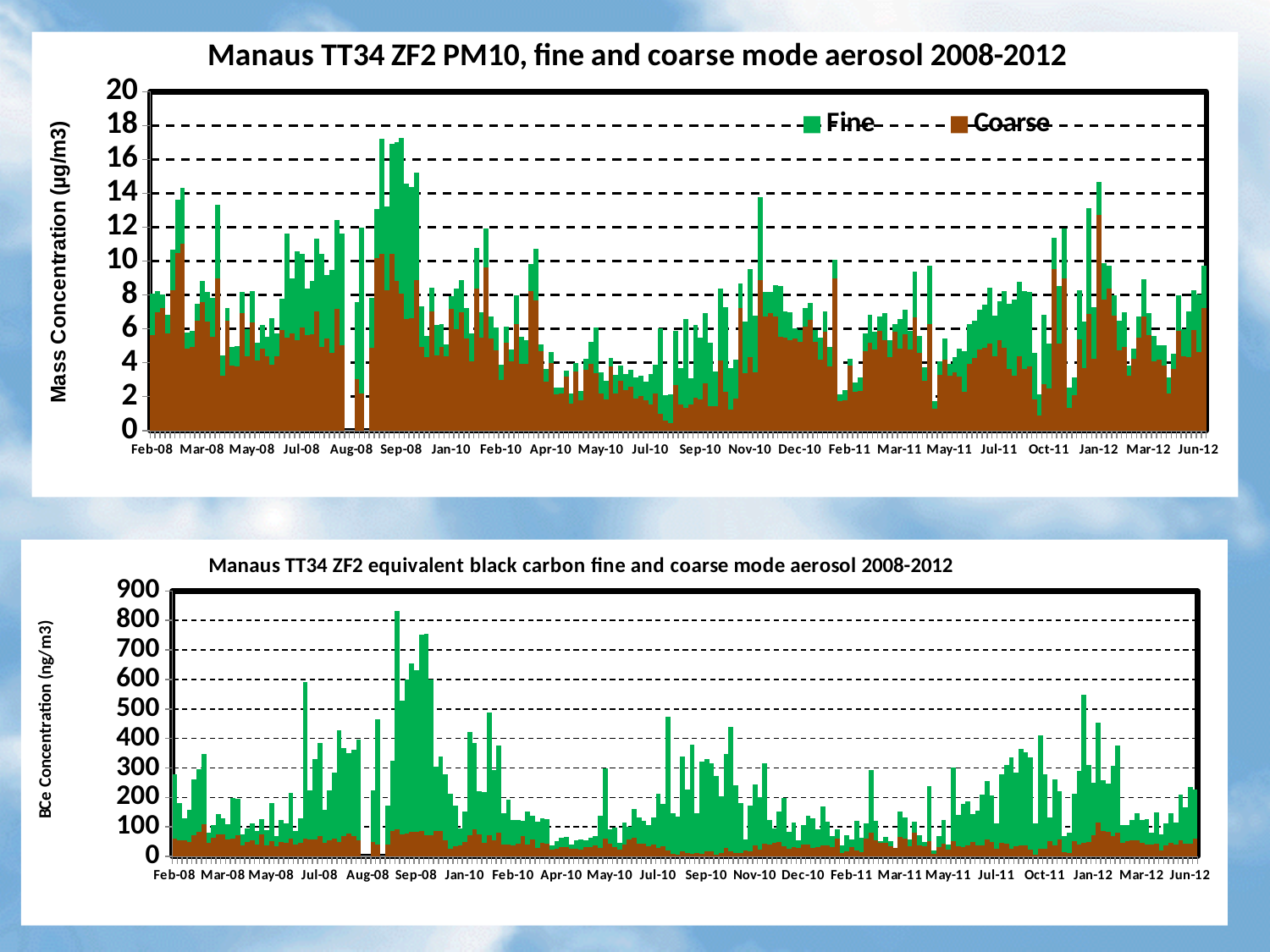
In the bottom chart, is the highest peak greater or less than 900? less In the bottom chart, which series contributes more to the bars, Fine or Coarse? Fine In the top chart, is the highest peak (around Sep-08) greater or less than 16? greater What is the y-axis label of the top chart? Mass Concentration (µg/m3) What is the highest tick value on the y axis of the bottom chart? 900 In the bottom chart, is the highest peak (around Sep-08) greater or less than 800? greater In the top chart, is the peak around Sep-08 higher or lower than the peak around Jan-12? higher What kind of chart is the top chart on the slide? bar chart In the bottom chart, is the peak around Sep-08 higher or lower than the peak around Jan-12? higher What are the two series named in the legend of the top chart? Fine and Coarse How many series does the legend of the top chart list? 2